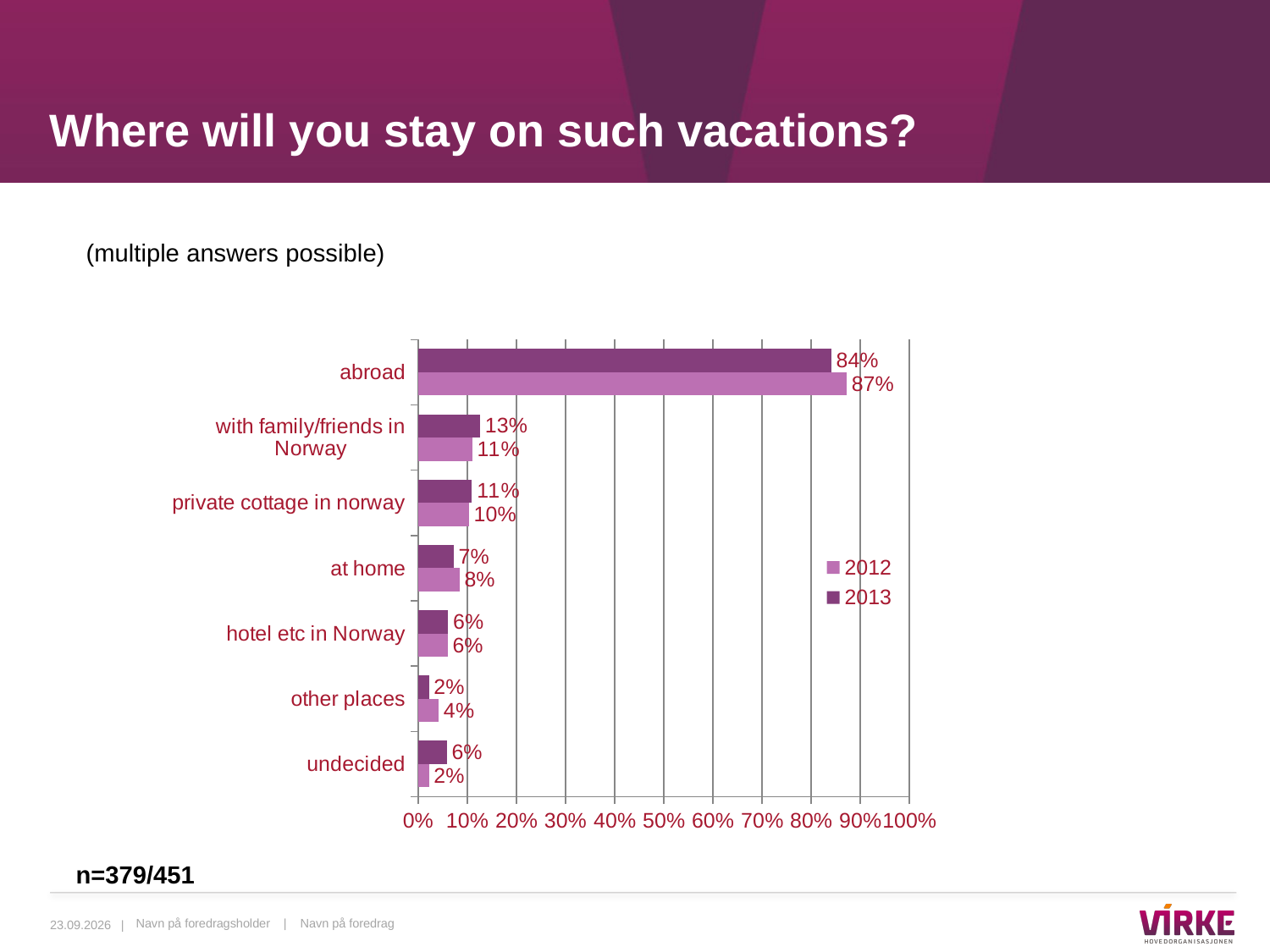
What are the two series listed in the legend? 2012 and 2013 What kind of chart is shown on the slide? bar chart How many categories are shown on the chart? 7 Which is larger for "undecided": the 2012 value or the 2013 value? 2013 Which category has the lowest value in 2013? other places What is the 2013 value for "abroad"? 84% What is the difference between the 2012 and 2013 values for "abroad"? 3% What is the 2012 value for "abroad"? 87% What is the 2012 value for "undecided"? 2% How many series does the legend list? 2 Which category has the highest value in 2012? abroad What is the 2013 value for "with family/friends in Norway"? 13%